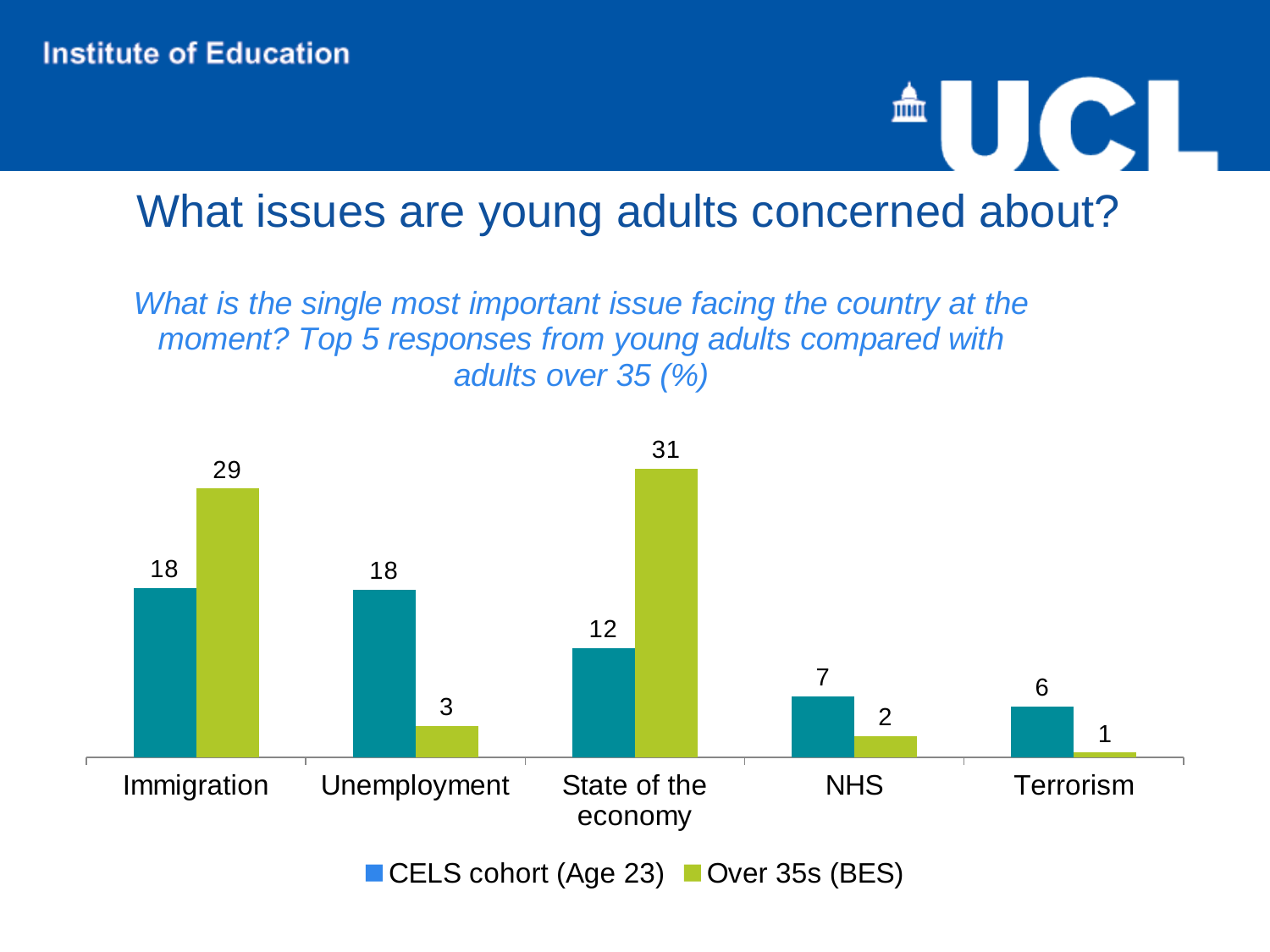
What is the value for Over 35s (BES) for Unemployment? 3 How many categories are shown on the x axis? 5 Which category has the highest value for Over 35s (BES)? State of the economy How many series does the legend list? 2 Which category has the lowest value for the CELS cohort (Age 23)? Terrorism What is the value for the CELS cohort (Age 23) for Terrorism? 6 What are the two series named in the legend? CELS cohort (Age 23) and Over 35s (BES) Which is larger for NHS: the CELS cohort (Age 23) value or the Over 35s (BES) value? CELS cohort (Age 23) What is the value for the CELS cohort (Age 23) for Immigration? 18 What is the difference between the Over 35s (BES) and CELS cohort (Age 23) values for Immigration? 11 What kind of chart is shown on the slide? Bar chart What is the value for Over 35s (BES) for State of the economy? 31